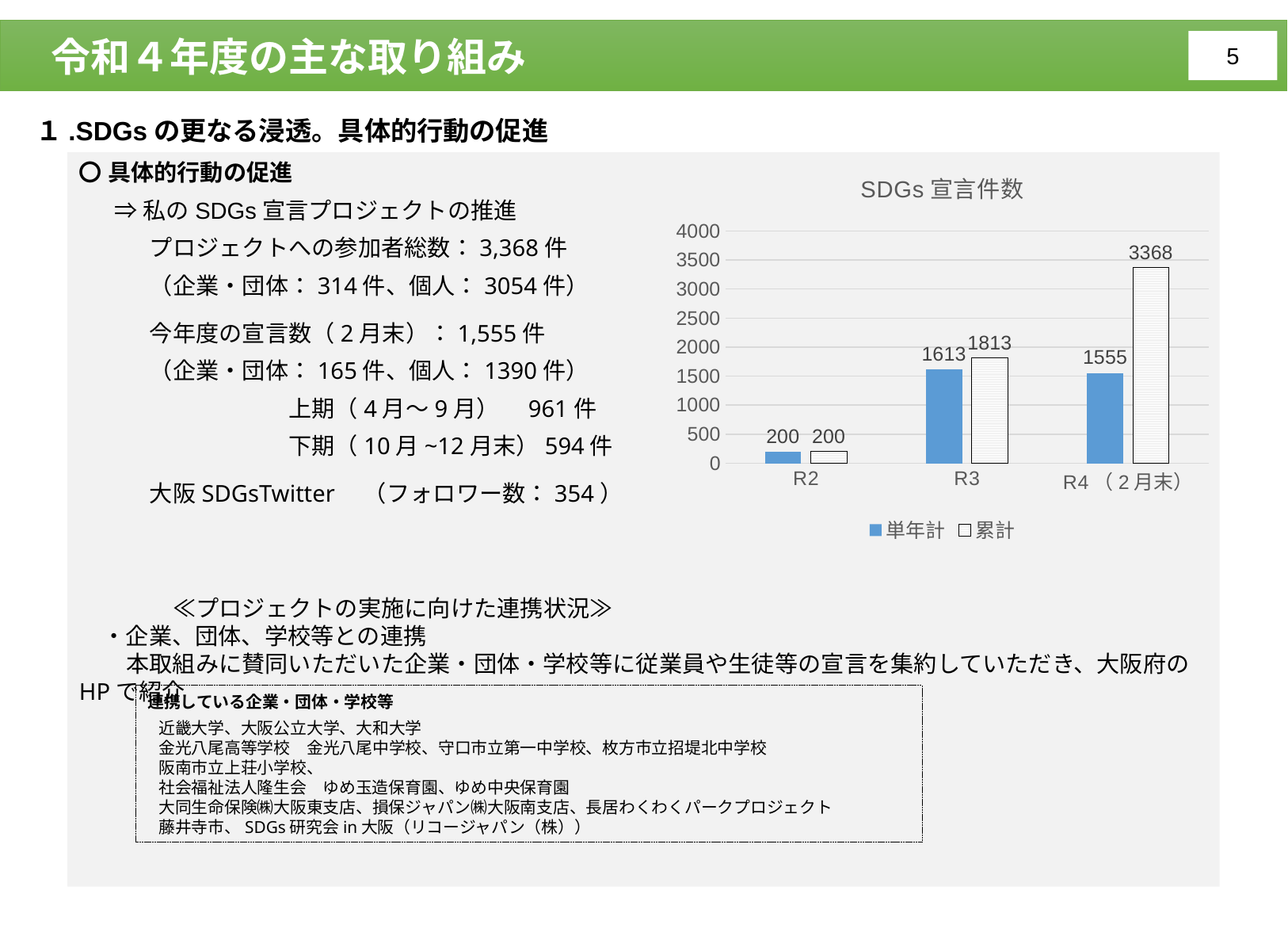
Does the 累計 series rise or fall from R2 to R4（2月末）? rise Which category has the lowest 単年計 value? R2 What is the 累計 value for R4（2月末）? 3368 What is the title of the chart? SDGs 宣言件数 Which is larger, the 単年計 value for R3 or the 単年計 value for R4（2月末）? R3 What is the 累計 value for R2? 200 What type of chart is shown on the slide? bar chart How many categories are shown on the x axis of the chart? 3 Which category has the highest 累計 value? R4（2月末） What is the difference between the 累計 and 単年計 values for R4（2月末）? 1813 What is the 単年計 value for R3? 1613 How many series does the chart legend list? 2